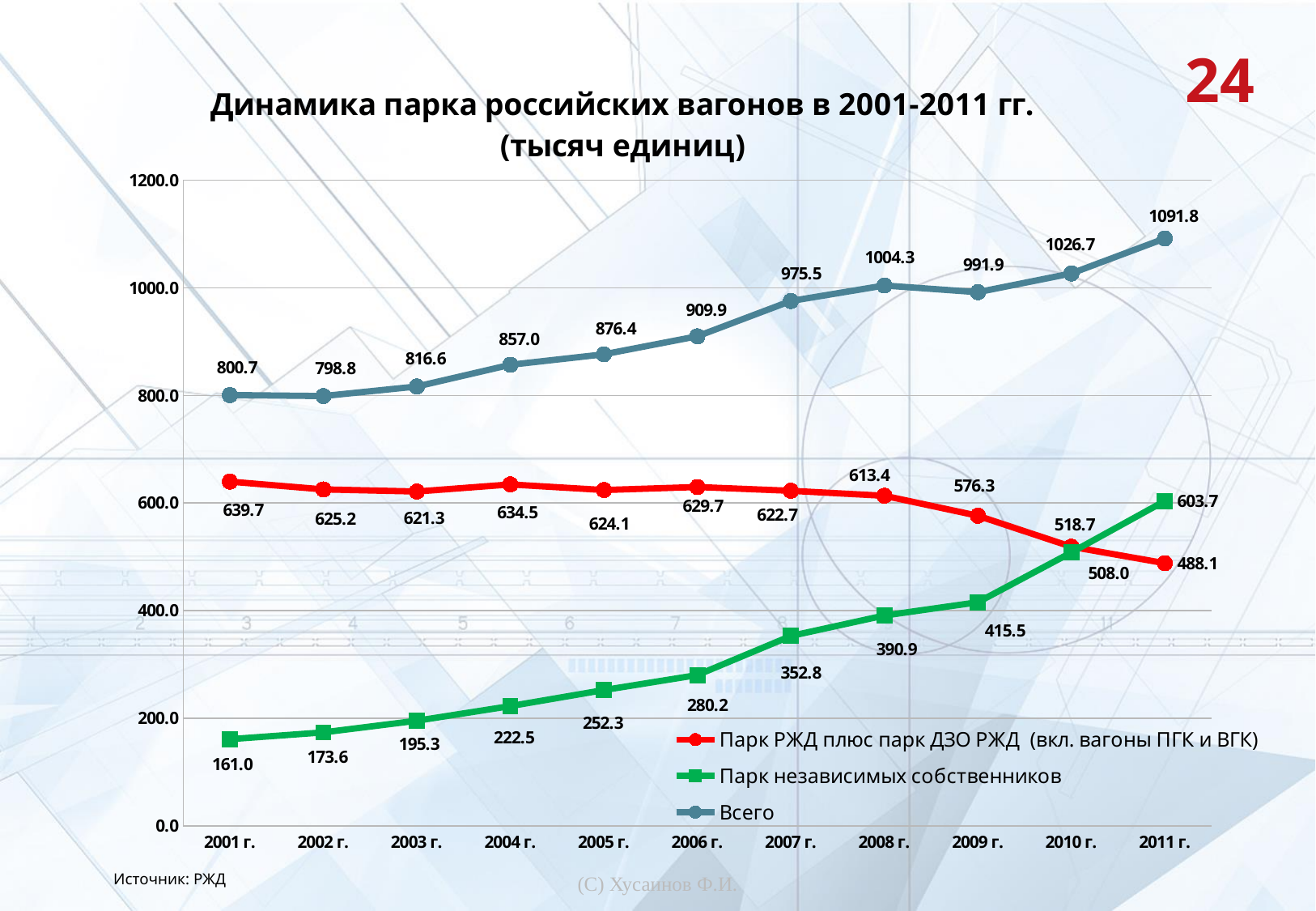
What is the value of the 'Парк независимых собственников' series for 2001 г.? 161.0 What is the value of the 'Парк РЖД плюс парк ДЗО РЖД' series for 2009 г.? 576.3 What type of chart is shown on the slide? line chart What is the title of the chart? Динамика парка российских вагонов в 2001-2011 гг. (тысяч единиц) Does the 'Парк независимых собственников' series rise or fall from 2001 г. to 2011 г.? rise In which year is the 'Парк РЖД плюс парк ДЗО РЖД' series at its highest? 2001 г. In which year is the 'Всего' series at its lowest? 2002 г. In 2011 г., which is larger: 'Парк независимых собственников' or 'Парк РЖД плюс парк ДЗО РЖД'? Парк независимых собственников How many series does the legend list? 3 How many years are shown on the x axis? 11 What is the value of the 'Всего' series for 2011 г.? 1091.8 What is the difference between the 'Всего' values for 2011 г. and 2001 г.? 291.1